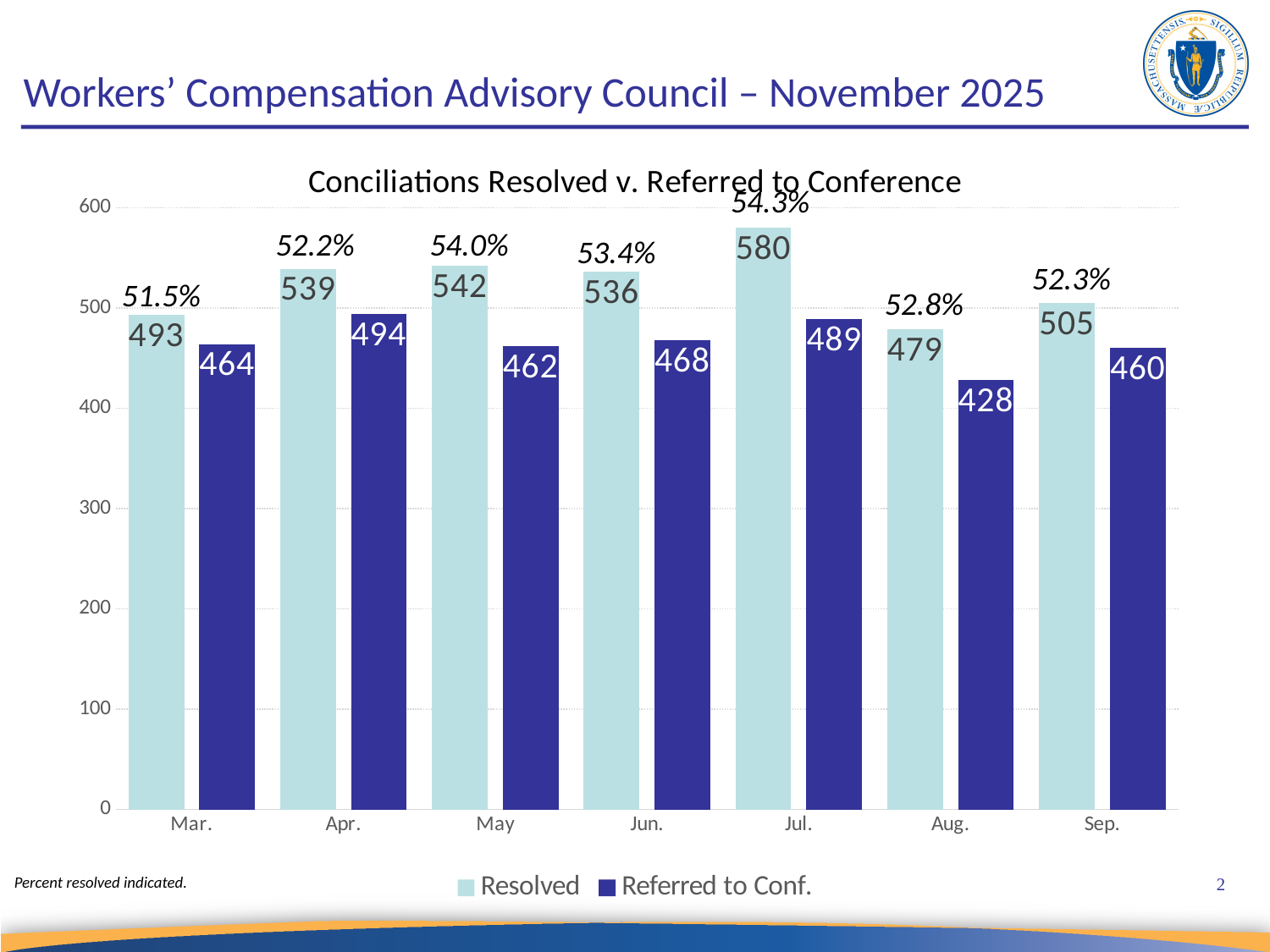
What is the title of the chart? Conciliations Resolved v. Referred to Conference What is the Resolved value for Jul.? 580 Which month has the lowest Referred to Conf. value? Aug. How many series does the legend list? 2 What kind of chart is shown? bar chart What percent resolved is indicated for May? 54.0% Which month has the highest Resolved value? Jul. Is the Referred to Conf. value for Mar. greater or less than 500? less What is the Referred to Conf. value for Aug.? 428 How many months are shown on the x axis? 7 What is the difference between the Resolved and Referred to Conf. values for Jul.? 91 Which is larger, the Resolved value for Apr. or the Resolved value for Sep.? Apr.